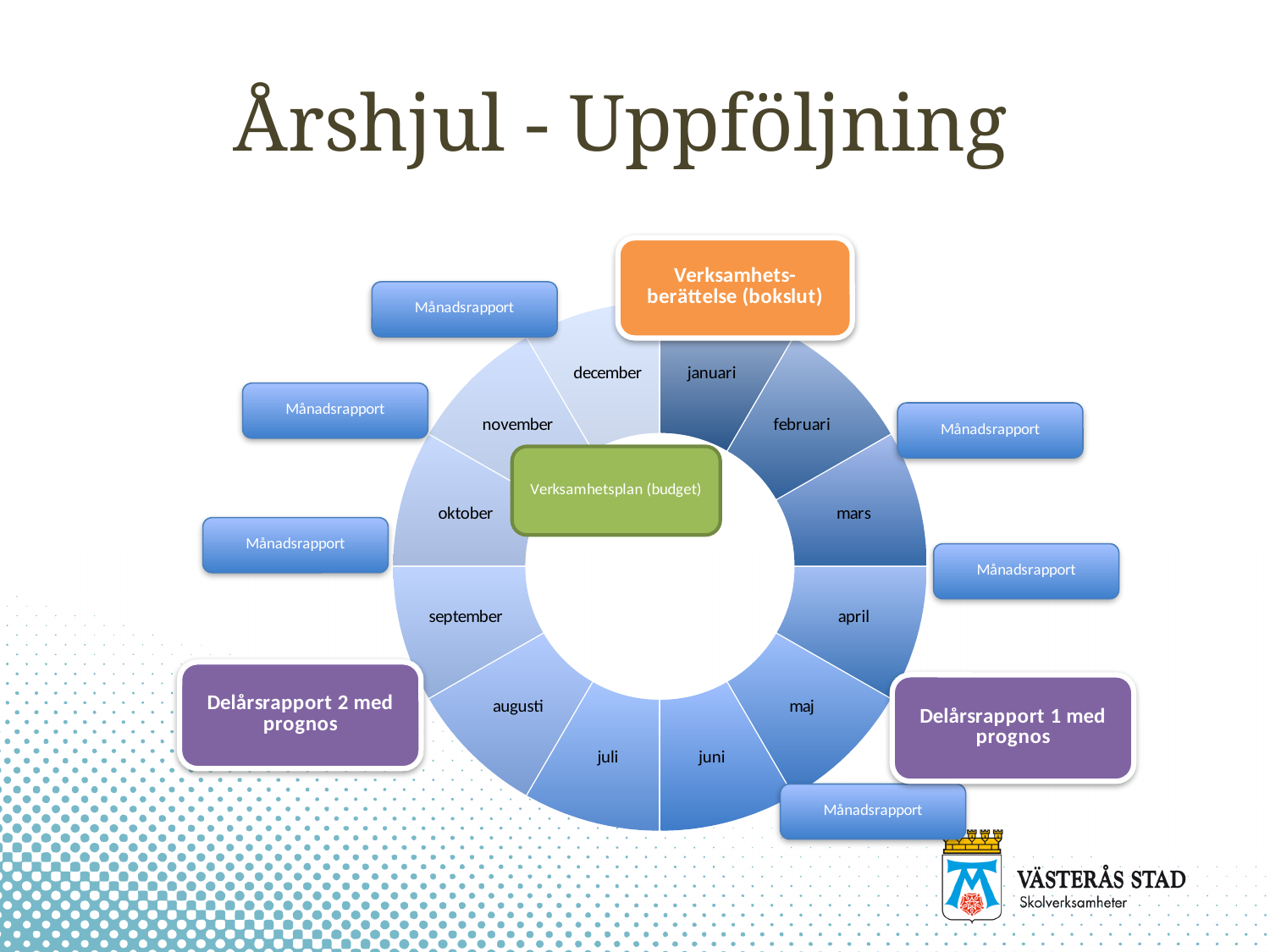
Which month segment comes immediately after 'december' going clockwise around the doughnut chart? januari How many segments does the doughnut chart have? 12 Which month segment is labelled between 'mars' and 'maj' on the doughnut chart? april Which month segment is labelled between 'augusti' and 'oktober' on the doughnut chart? september What is the title of the slide containing the doughnut chart? Årshjul - Uppföljning What kind of chart is shown on the slide? Doughnut chart What label is shown in the centre of the doughnut chart? Verksamhetsplan (budget)